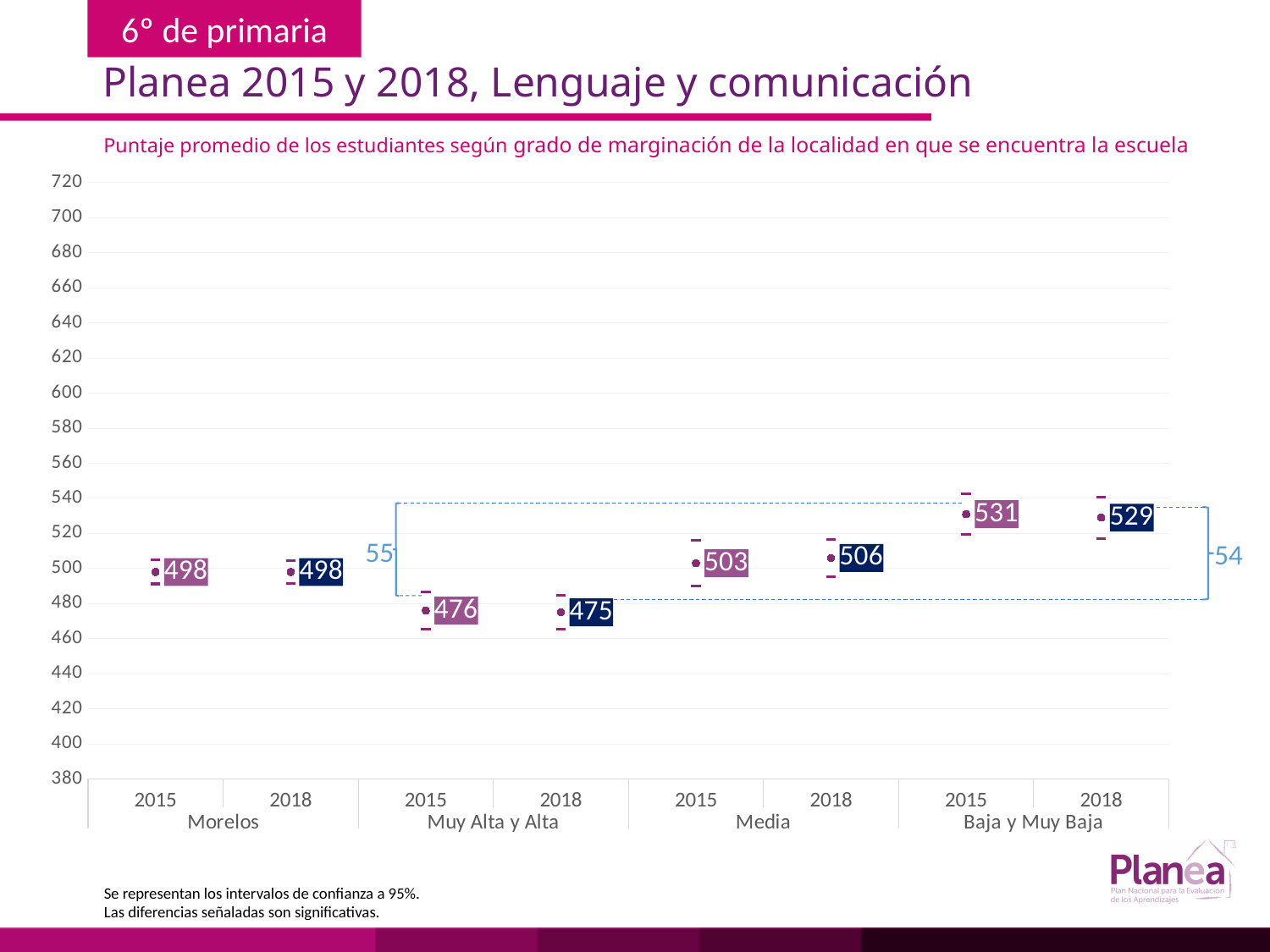
What is the 2018 value for Media? 506 Which is larger, the 2015 value for Media or the 2015 value for Morelos? Media (503) What is the subtitle printed above the chart? Puntaje promedio de los estudiantes según grado de marginación de la localidad en que se encuentra la escuela Which group and year has the highest plotted value? Baja y Muy Baja, 2015 Which group and year has the lowest plotted value? Muy Alta y Alta, 2018 What is the 2015 value for Morelos? 498 What is the difference between the 2018 values for Media and Muy Alta y Alta? 31 What is the 2018 value for Muy Alta y Alta? 475 Did the value for Baja y Muy Baja rise or fall from 2015 to 2018? fall How many data points are plotted on the chart? 8 What is the difference between the 2015 values for Baja y Muy Baja and Muy Alta y Alta? 55 What is the 2015 value for Baja y Muy Baja? 531